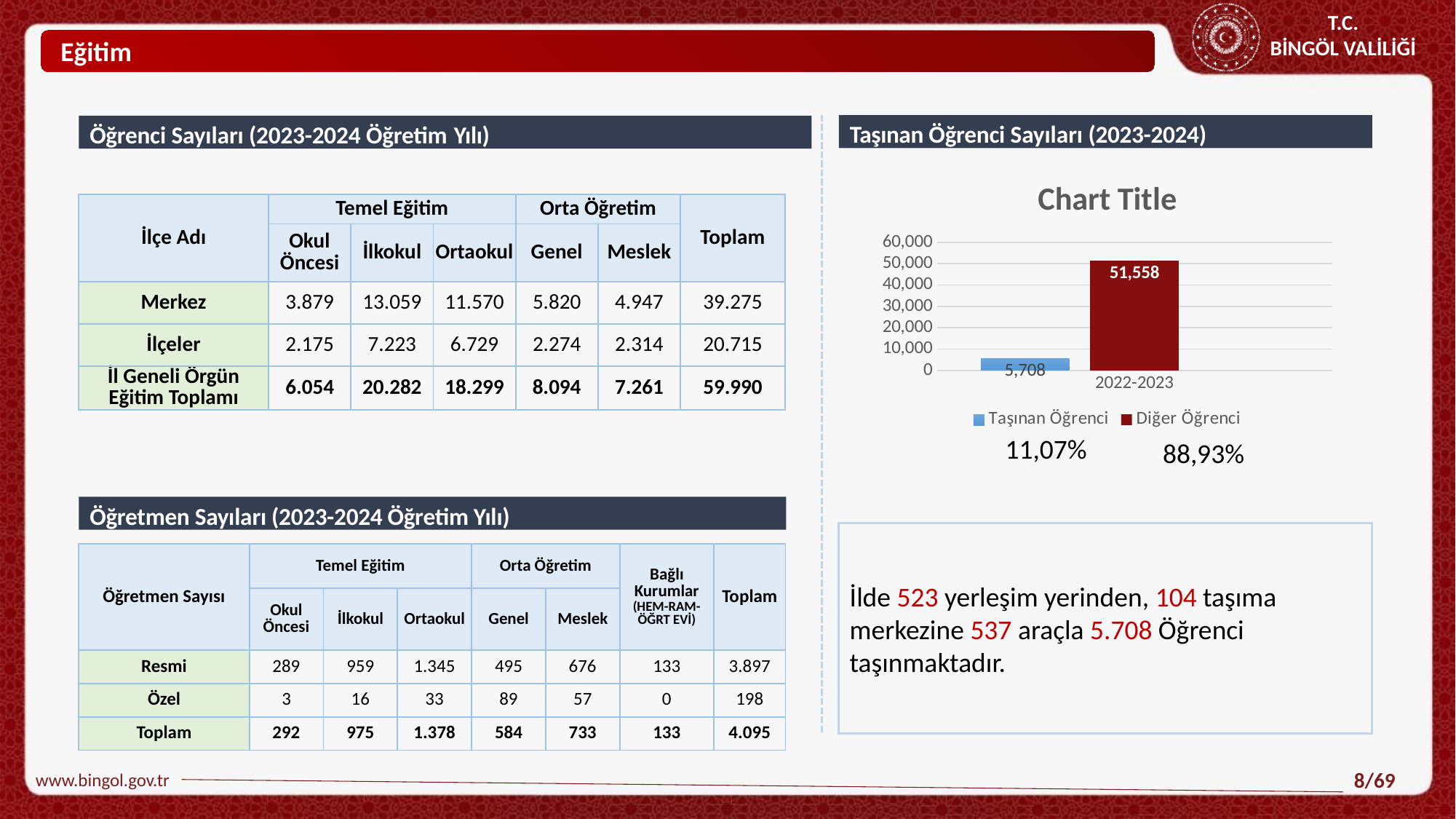
Which series has the lowest value in the chart? Taşınan Öğrenci What is the value of the Diğer Öğrenci bar in the chart? 51,558 How many series does the chart's legend list? 2 What is the value of the Taşınan Öğrenci bar in the chart? 5,708 What is the difference between the Diğer Öğrenci and Taşınan Öğrenci values in the chart? 45,850 What is the title displayed above the bar chart? Chart Title Is the value for Taşınan Öğrenci in the chart greater or less than 10,000? less What is the highest value shown on the chart's y axis? 60,000 What type of chart is shown under "Taşınan Öğrenci Sayıları (2023-2024)"? bar chart Is the value for Diğer Öğrenci in the chart greater or less than 50,000? greater What category label is shown on the x axis of the chart? 2022-2023 Which series has the higher value in the chart, Taşınan Öğrenci or Diğer Öğrenci? Diğer Öğrenci